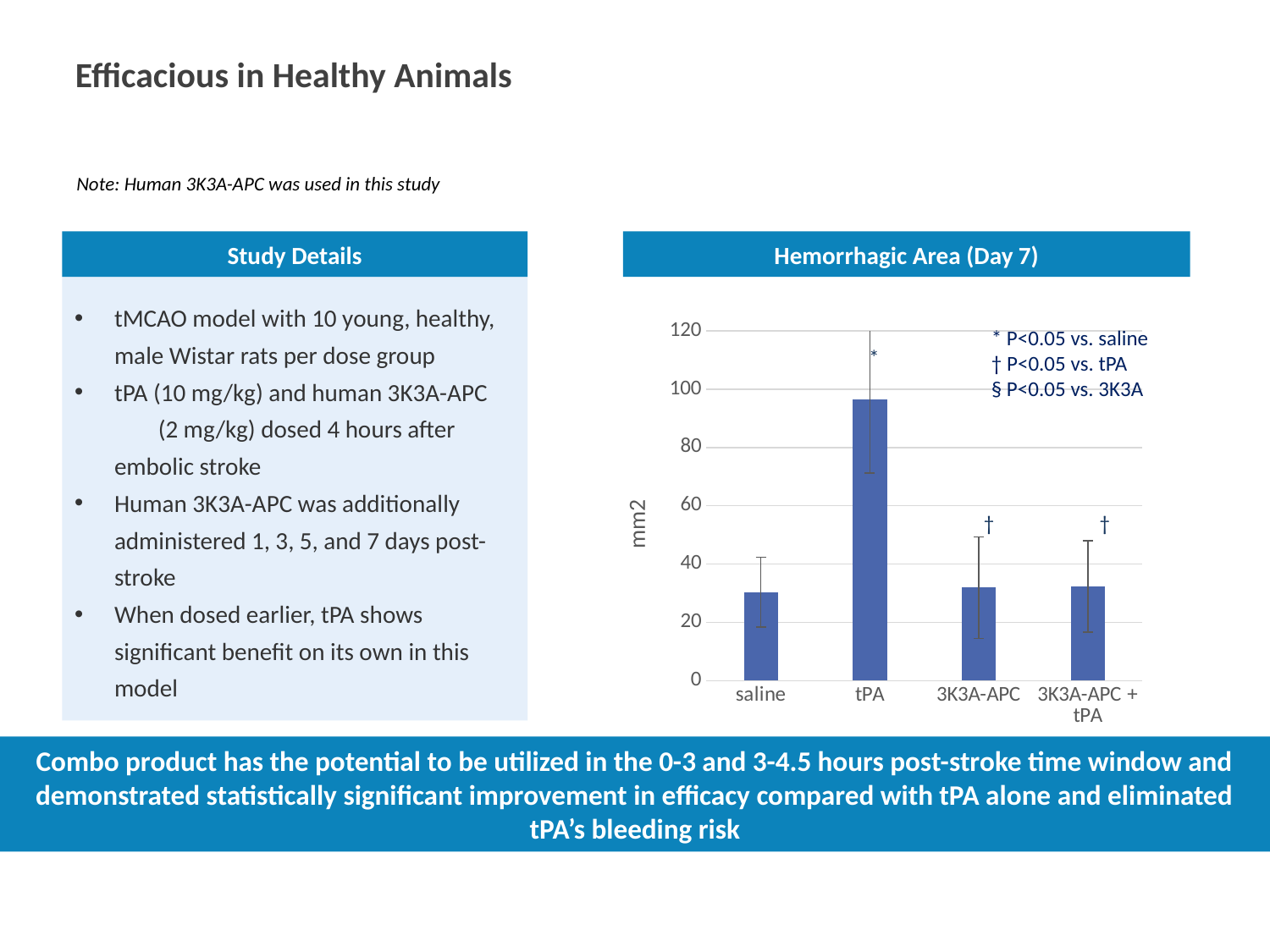
In the Hemorrhagic Area (Day 7) chart, is the value for 3K3A-APC greater or less than 20? greater In the Hemorrhagic Area (Day 7) chart, which is larger: the value for tPA or the value for 3K3A-APC? tPA What is the label on the vertical axis of the Hemorrhagic Area (Day 7) chart? mm2 What kind of chart is shown under the heading "Hemorrhagic Area (Day 7)"? Bar chart In the Hemorrhagic Area (Day 7) chart, is the value for tPA greater or less than 80? greater What is the highest tick value shown on the vertical axis of the Hemorrhagic Area (Day 7) chart? 120 Which dose group has the highest hemorrhagic area in the Hemorrhagic Area (Day 7) chart? tPA How many dose groups (categories) are plotted in the Hemorrhagic Area (Day 7) chart? 4 In the Hemorrhagic Area (Day 7) chart, which bar is marked with an asterisk (*)? tPA In the Hemorrhagic Area (Day 7) chart, which is larger: the value for saline or the value for tPA? tPA In the Hemorrhagic Area (Day 7) chart, is the value for 3K3A-APC + tPA greater or less than 60? less